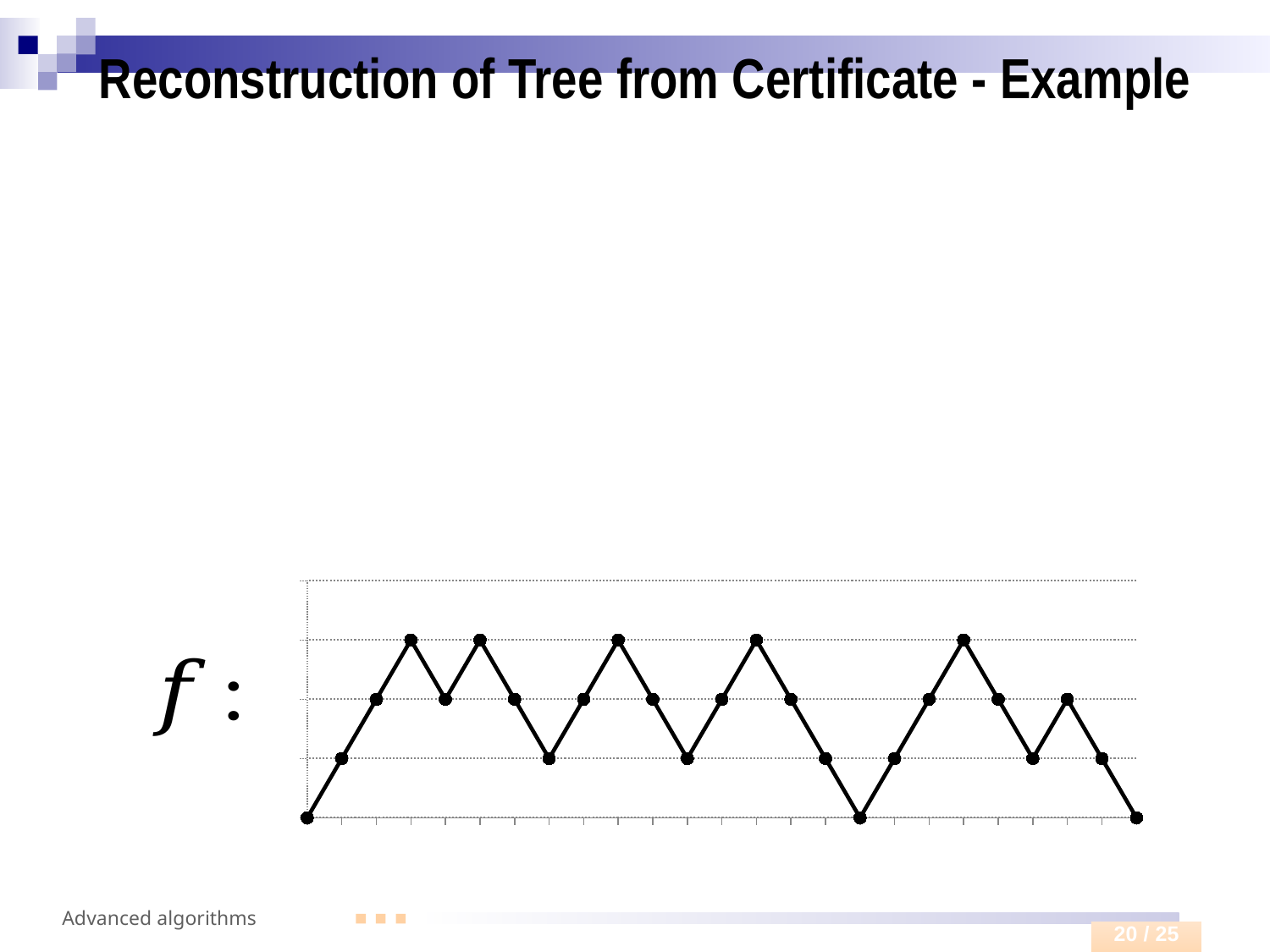
How many points reach the highest level on the chart? 5 How many data points are plotted on the line? 25 What label appears to the left of the chart? f : Which is higher, the fourth point from the left or the second point from the left? the fourth point Does the chart have a legend? no Does the line rise or fall between the first point and the second point? rise What kind of chart is shown on the slide? line chart Does the line rise or fall between the second-to-last point and the last point? fall How many points lie on the lowest level (the baseline) of the chart? 3 What colour is the plotted line and its markers? black Is the last point of the line higher than, lower than, or at the same level as the first point? same level